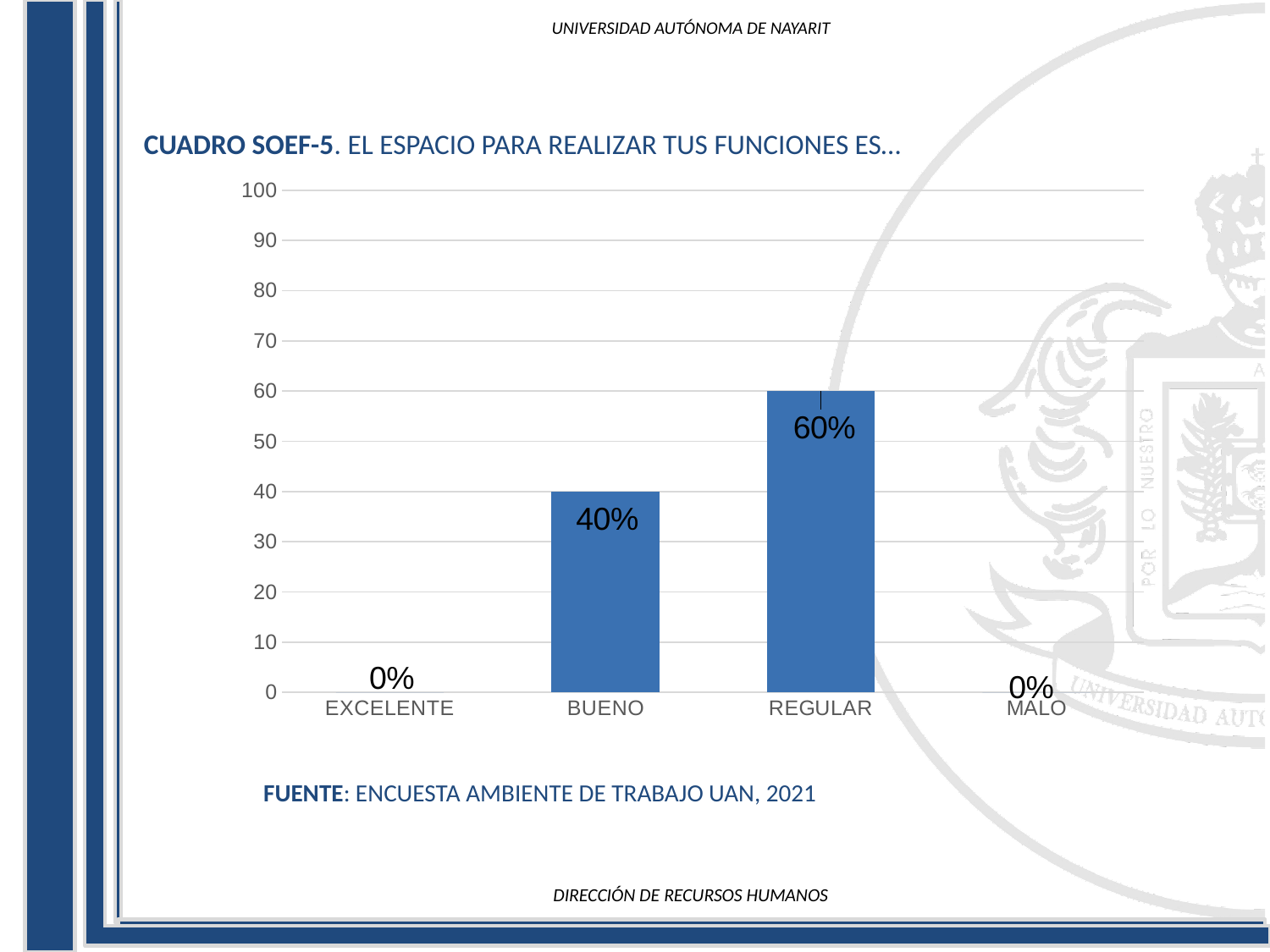
What is the value for BUENO? 40% What is the title of the chart? CUADRO SOEF-5. EL ESPACIO PARA REALIZAR TUS FUNCIONES ES… What is the value for EXCELENTE? 0% Which is larger, the value for BUENO or the value for REGULAR? REGULAR What is the value for REGULAR? 60% Which category has the highest value? REGULAR What is the source cited below the chart? ENCUESTA AMBIENTE DE TRABAJO UAN, 2021 What is the difference between the values for REGULAR and BUENO? 20% How many categories are shown on the x axis? 4 What is the value for MALO? 0% Is the value for REGULAR greater or less than 50? greater What kind of chart is shown on the slide? bar chart